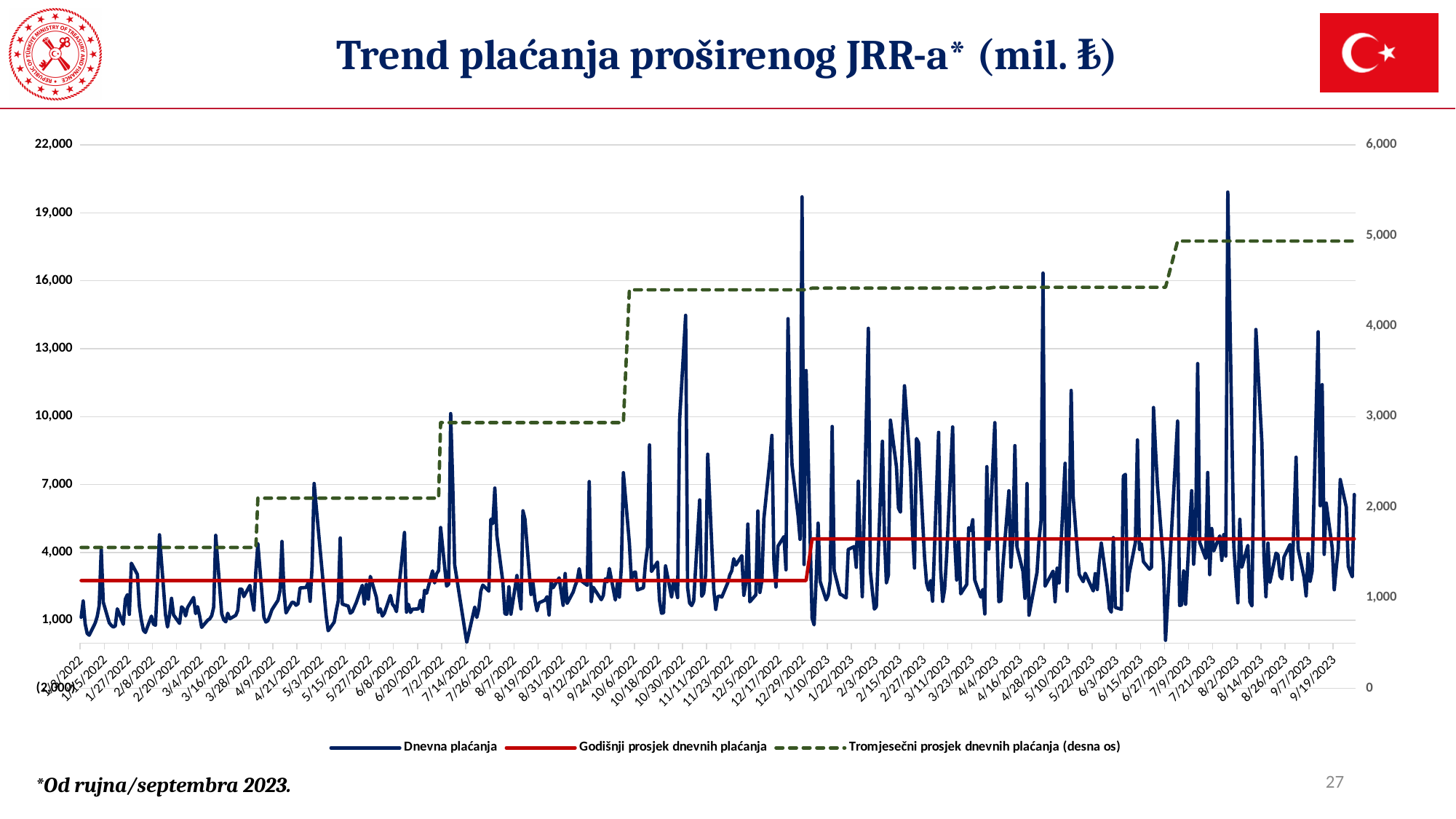
Is the annual average of daily payments (red line) higher in 2023 or in 2022? 2023 Which series is plotted on the right axis according to the legend? Tromjesečni prosjek dnevnih plaćanja What is the highest tick value shown on the left axis? 22,000 What kind of chart is shown on the slide? line chart What is the title of the chart? Trend plaćanja proširenog JRR-a* (mil. ₺) Is the quarterly average of daily payments at the start of 2022 greater or less than 2,000 on the right axis? less How many series does the legend list? 3 Is the annual average of daily payments in 2022 greater or less than 4,000 on the left axis? less Does the quarterly average of daily payments (green dashed line) rise or fall over the period shown? rise Is the quarterly average of daily payments from July 2023 onward greater or less than 4,000 on the right axis? greater